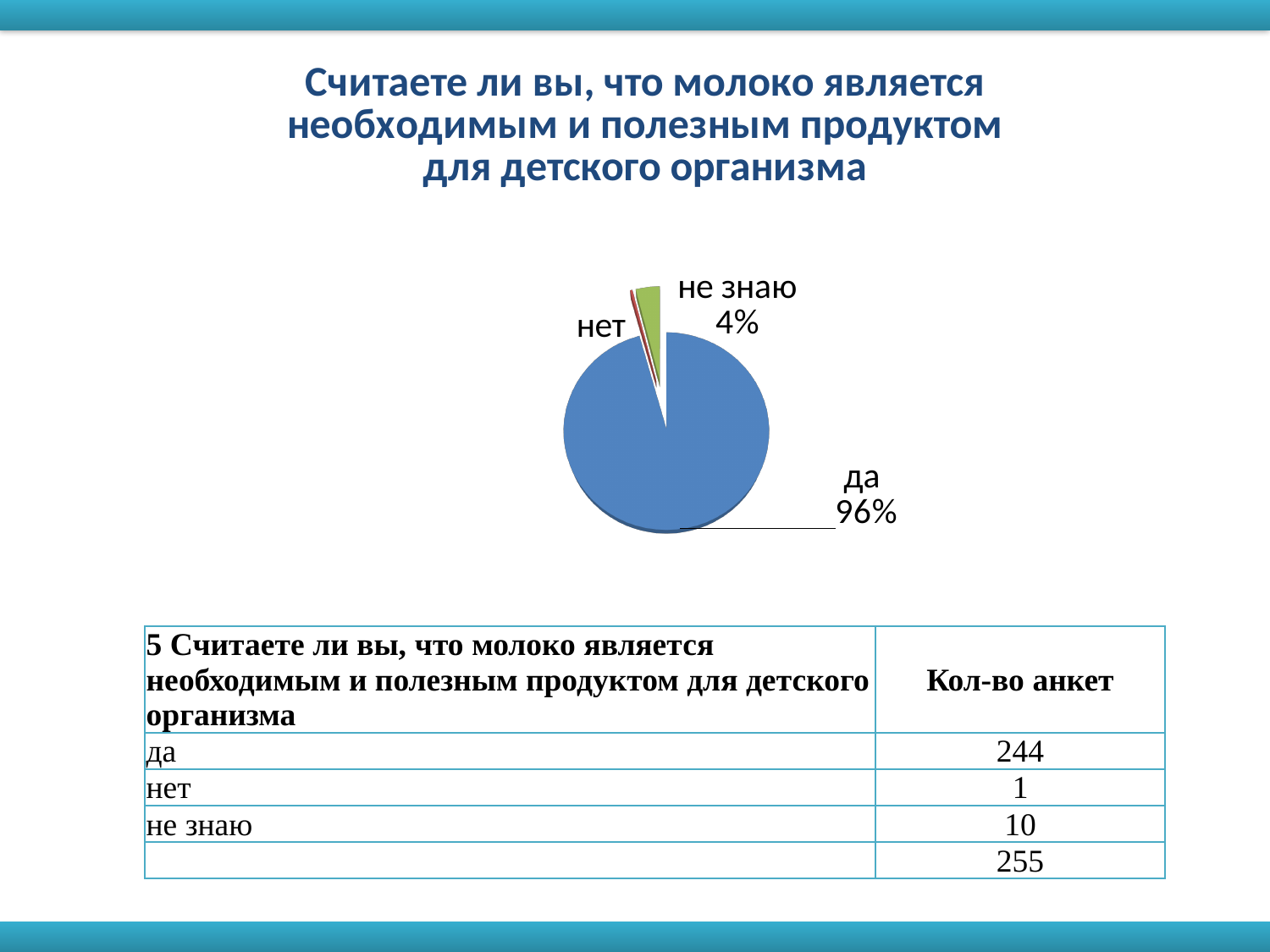
What share of the pie does the "не знаю" slice represent? 4% Which slice is larger, "да" or "не знаю"? да Which slice is larger, "не знаю" or "нет"? не знаю What colour is the "не знаю" slice of the pie chart? green Which slice of the pie chart is the smallest? нет What share of the pie does the "да" slice represent? 96% What colour is the "да" slice of the pie chart? blue What kind of chart is shown on the slide? pie chart Which slice of the pie chart is the largest? да What is the difference in percentage points between the "да" slice and the "не знаю" slice? 92% How many slices does the pie chart have? 3